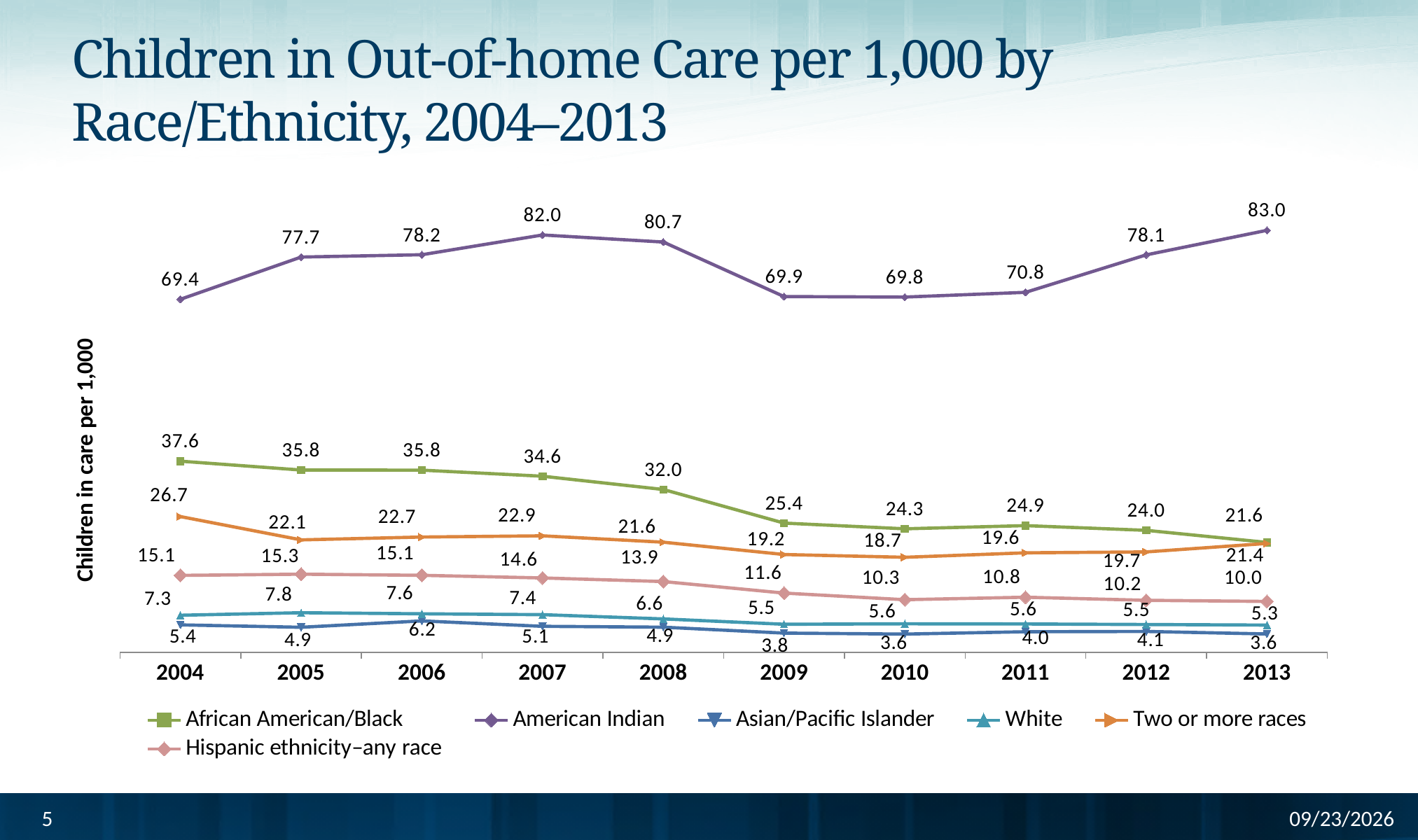
What is the difference between the African American/Black values in 2004 and 2013? 16.0 How many series does the legend list? 6 Does the African American/Black series generally rise or fall from 2004 to 2013? Fall How many years are shown on the x axis? 10 In which year is the African American/Black value lowest? 2013 What is the value for African American/Black in 2004? 37.6 In which year is the American Indian value highest? 2013 What is the value for Hispanic ethnicity–any race in 2013? 10.0 What is the value for Two or more races in 2009? 19.2 What is the value for American Indian in 2013? 83.0 What kind of chart is this? Line chart Which is larger in 2008: the White value or the Asian/Pacific Islander value? White